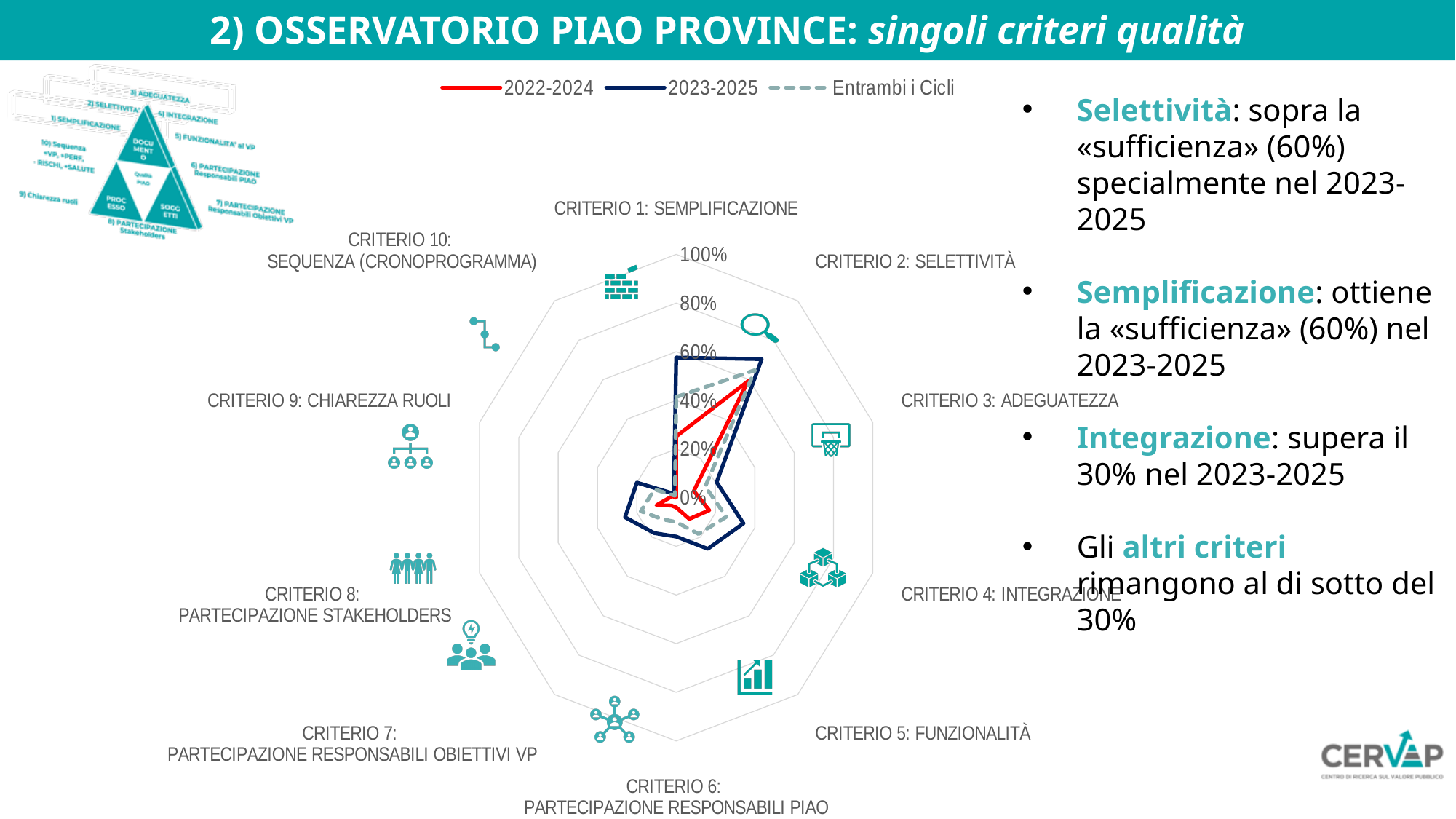
How many series does the legend of the radar chart list? 3 Is the 2023-2025 value for CRITERIO 4: INTEGRAZIONE greater or less than 60%? less For the 2022-2024 series, which criterion has the highest value? CRITERIO 2: SELETTIVITÀ For CRITERIO 1: SEMPLIFICAZIONE, which series has the larger value, 2022-2024 or 2023-2025? 2023-2025 Which series are listed in the legend of the radar chart? 2022-2024, 2023-2025, Entrambi i Cicli Is the 2023-2025 value for CRITERIO 3: ADEGUATEZZA greater or less than 40%? less Is the 2022-2024 value for CRITERIO 2: SELETTIVITÀ greater or less than 40%? greater What is the highest value shown on the radar chart's axis scale? 100% What kind of chart is shown on the slide? Radar chart How many criteria (categories) are plotted on the radar chart? 10